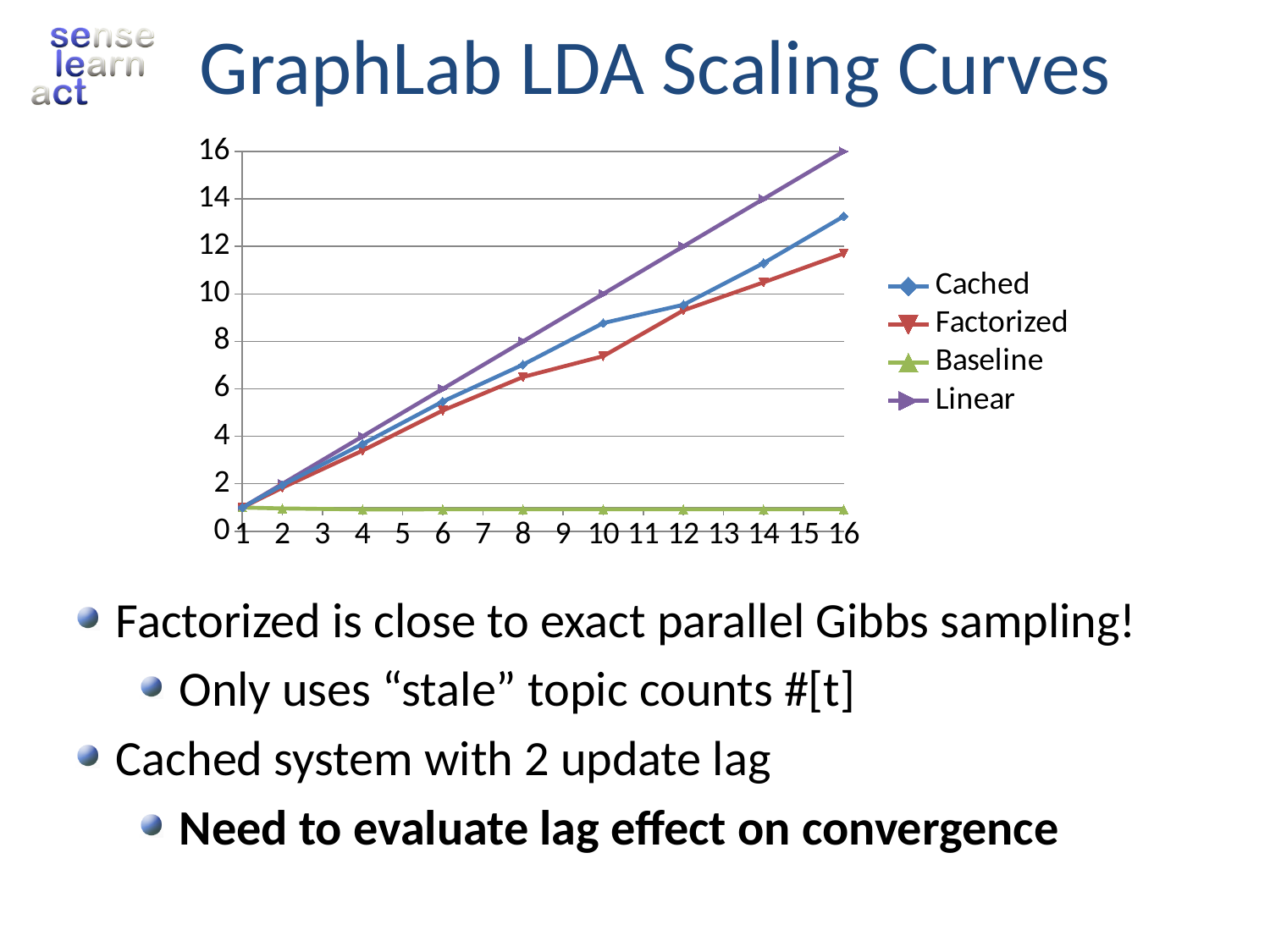
Is the value of Baseline at x = 16 greater or less than 2? less What kind of chart is shown on the slide? line chart Which series is plotted in purple? Linear How many series does the legend list? 4 Which series has the lowest value at x = 16? Baseline Is the value of Cached at x = 16 greater or less than 12? greater Which series has the highest value at x = 16? Linear Does the Cached series rise or fall as x increases from 1 to 16? rise Is the value of Factorized at x = 10 greater or less than 8? less At x = 16, which is larger, Cached or Factorized? Cached What is the value of the Linear series at x = 16? 16 What is the value of the Linear series at x = 8? 8